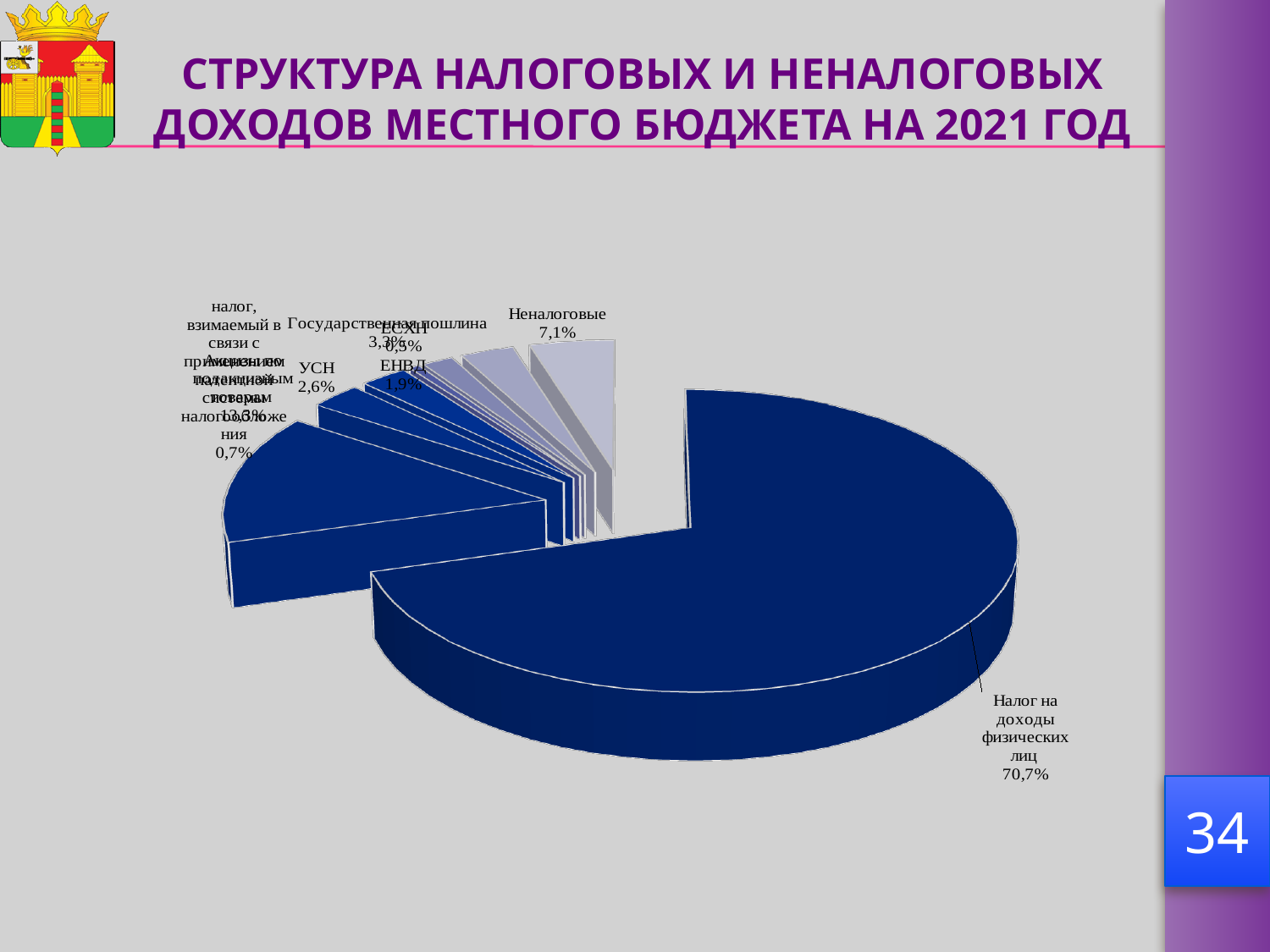
Which category has the smallest share of the pie? ЕСХН Which is larger, the share of "УСН" or the share of "ЕНВД"? УСН What kind of chart is shown on the slide? pie chart What is the value shown for "Государственная пошлина"? 3,3% What is the value shown for "ЕСХН"? 0,5% What is the value shown for "УСН"? 2,6% What share of the pie does "Налог на доходы физических лиц" have? 70,7% What is the value shown for "ЕНВД"? 1,9% Which category has the largest share of the pie? Налог на доходы физических лиц What year does the slide title say the budget revenue structure refers to? 2021 What is the value shown for "Неналоговые"? 7,1% What is the difference between the shares of "Налог на доходы физических лиц" and "Неналоговые"? 63,6%